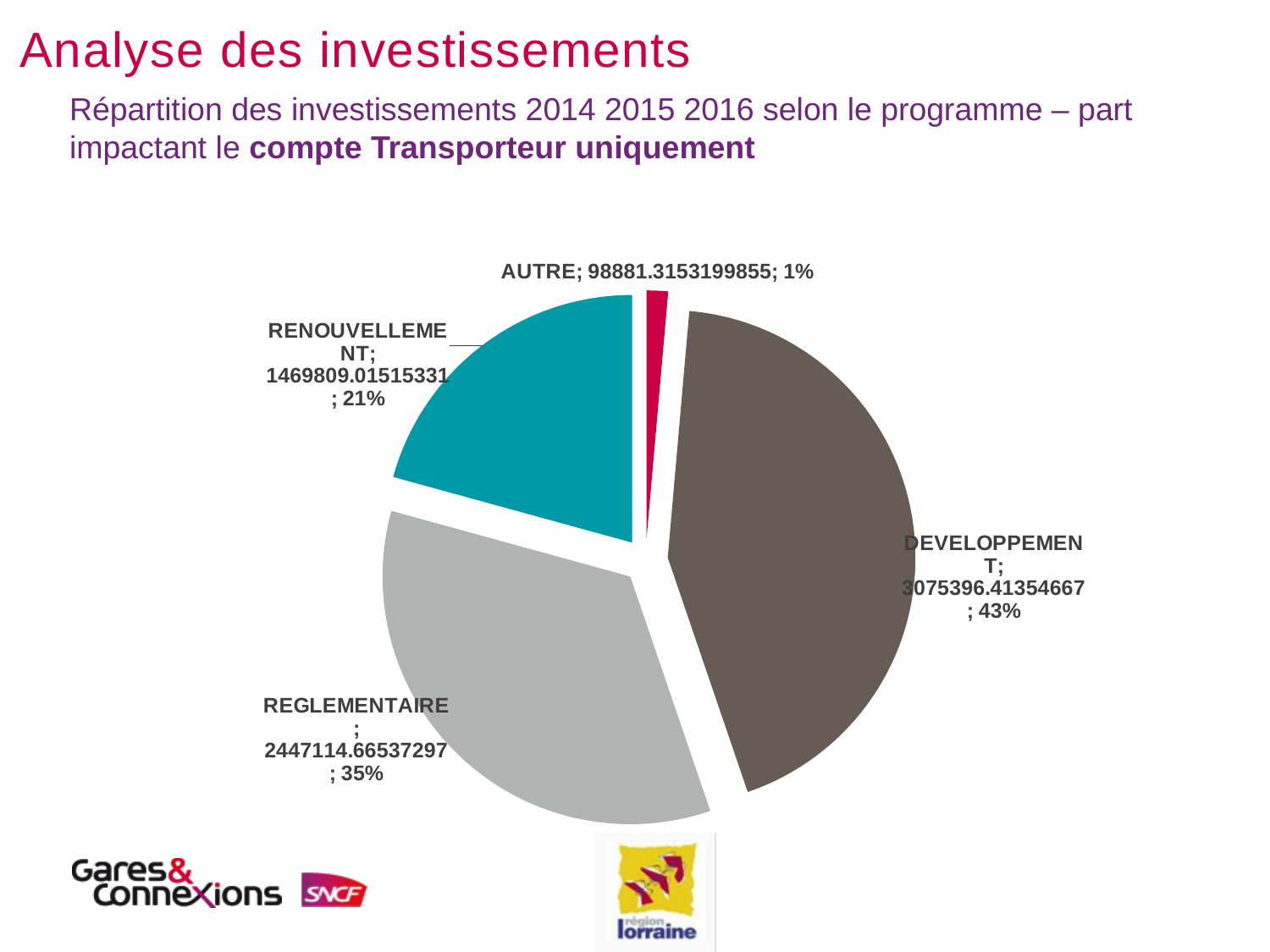
What share of the pie does REGLEMENTAIRE represent? 35% How many slices does the pie chart have? 4 What is the difference in percentage share between DEVELOPPEMENT and REGLEMENTAIRE? 8% Which category has the largest slice of the pie? DEVELOPPEMENT What kind of chart is shown on the slide? Pie chart What share of the pie does AUTRE represent? 1% Which slice is larger, REGLEMENTAIRE or RENOUVELLEMENT? REGLEMENTAIRE What is the value shown for AUTRE? 98881.3153199855 What share of the pie does RENOUVELLEMENT represent? 21% What is the value shown for DEVELOPPEMENT? 3075396.41354667 Which category has the smallest slice of the pie? AUTRE